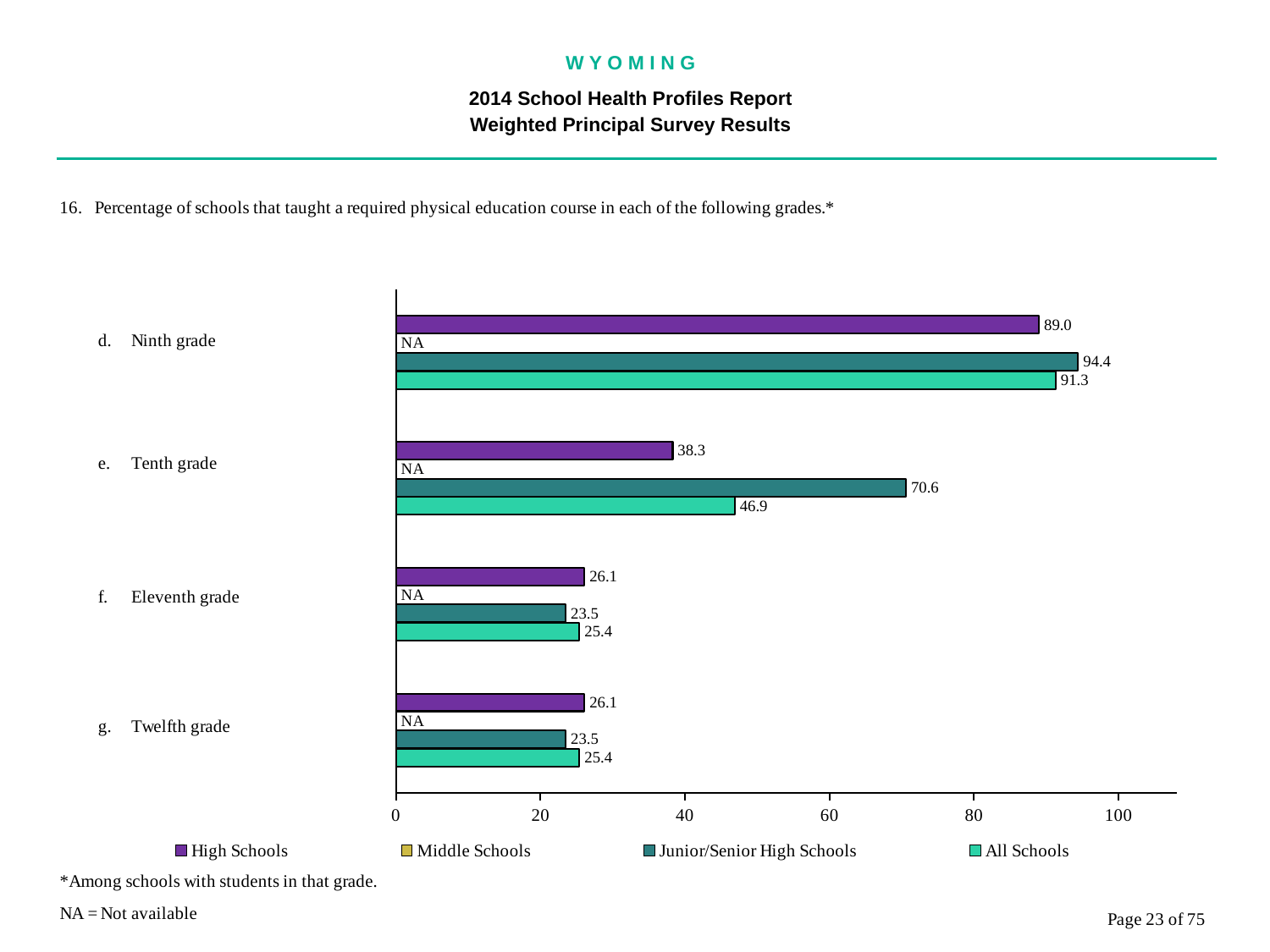
What kind of chart is shown on the slide? Bar chart Which grade has the lowest High Schools value? Eleventh grade and Twelfth grade (both 26.1) How many series does the legend list? 4 How many grade categories are shown on the chart? 4 What percentage of high schools taught a required physical education course in ninth grade? 89.0 Do the All Schools values rise or fall from ninth grade to twelfth grade? Fall What is the All Schools value for eleventh grade? 25.4 For ninth grade, which is larger: the High Schools value or the Junior/Senior High Schools value? Junior/Senior High Schools Which grade has the highest All Schools value? Ninth grade What value is shown for Middle Schools in twelfth grade? NA What is the value for Junior/Senior High Schools in tenth grade? 70.6 What is the difference between the Junior/Senior High Schools and High Schools values for tenth grade? 32.3